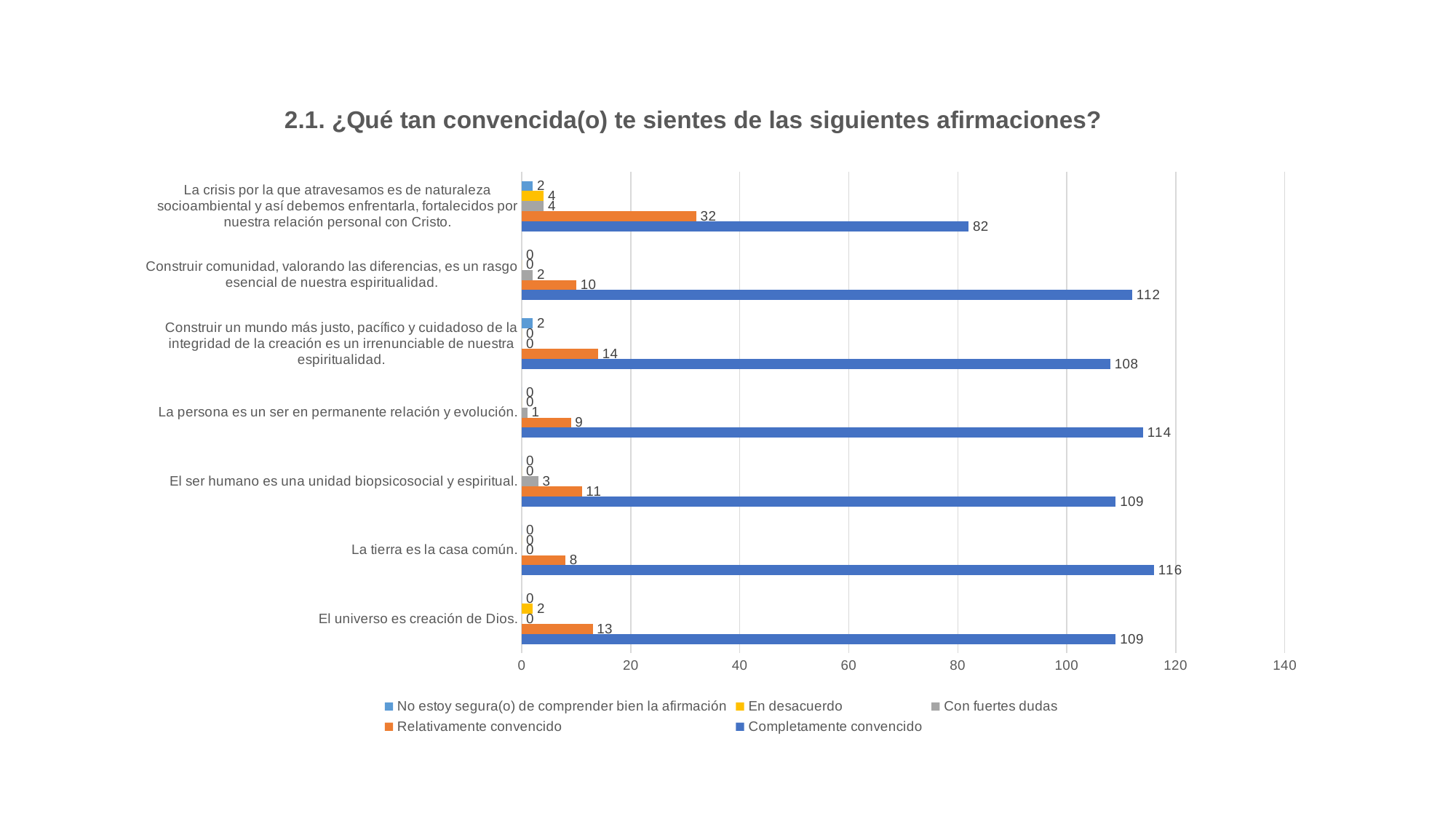
Is the "Completamente convencido" value for "Construir comunidad, valorando las diferencias, es un rasgo esencial de nuestra espiritualidad." greater or less than 100? greater What is the value of "Relativamente convencido" for "La crisis por la que atravesamos es de naturaleza socioambiental..."? 32 Which statement has the lowest "Completamente convencido" value? La crisis por la que atravesamos es de naturaleza socioambiental y así debemos enfrentarla, fortalecidos por nuestra relación personal con Cristo. What is the title of the chart? 2.1. ¿Qué tan convencida(o) te sientes de las siguientes afirmaciones? What is the difference between the "Completamente convencido" values for "La persona es un ser en permanente relación y evolución." and "Construir un mundo más justo, pacífico y cuidadoso de la integridad de la creación..."? 6 How many statements (categories) are plotted on the chart? 7 Which is larger: the "Relativamente convencido" value for "El universo es creación de Dios." or for "El ser humano es una unidad biopsicosocial y espiritual."? El universo es creación de Dios. What is the value of "Completamente convencido" for "La tierra es la casa común."? 116 What kind of chart is shown on the slide? bar chart Which statement has the highest "Completamente convencido" value? La tierra es la casa común. How many series does the legend list? 5 What is the value of "En desacuerdo" for "El universo es creación de Dios."? 2